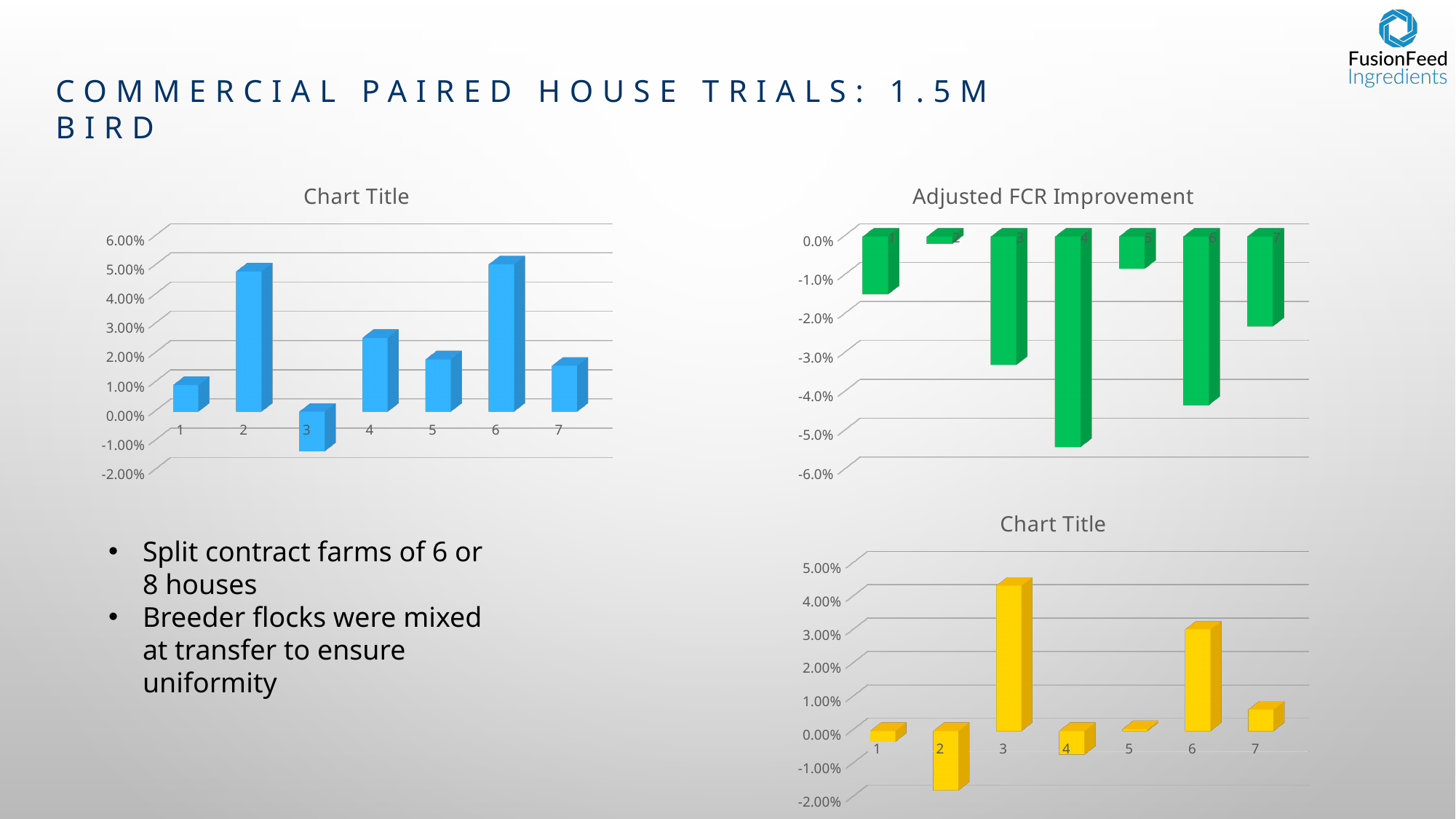
In the left chart titled 'Chart Title', which category has the lowest value? 3 In the bottom-right chart titled 'Chart Title', is the value for category 6 greater or less than 2.00%? greater How many categories are plotted in the left chart titled 'Chart Title'? 7 In the left chart titled 'Chart Title', which is larger, the value for category 4 or category 5? 4 In the 'Adjusted FCR Improvement' chart, which category has the lowest value? 4 In the 'Adjusted FCR Improvement' chart, is the value for category 4 greater or less than -5.0%? less In the bottom-right chart titled 'Chart Title', which category has the highest value? 3 In the 'Adjusted FCR Improvement' chart, which is larger, the value for category 3 or category 7? 7 In the left chart titled 'Chart Title', which category has the highest value? 6 In the 'Adjusted FCR Improvement' chart, which category has the highest value? 2 What kind of chart is the bottom-right chart titled 'Chart Title'? bar chart In the left chart titled 'Chart Title', is the value for category 2 greater or less than 4.00%? greater